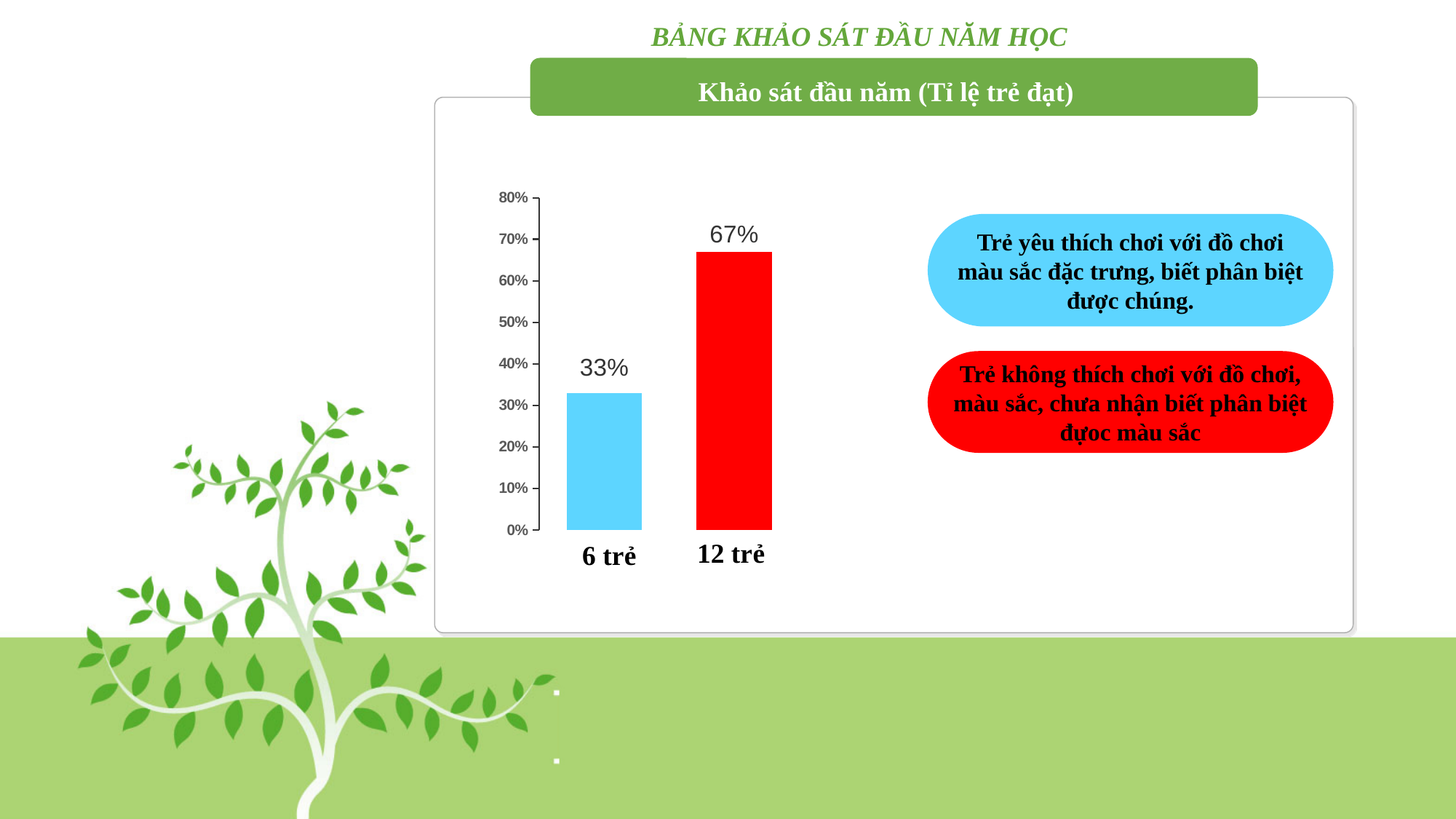
How many bars are plotted in the chart? 2 What is the difference between the "12 trẻ" value and the "6 trẻ" value? 34% What is the value shown for the "6 trẻ" bar? 33% Is the value for "12 trẻ" greater or less than 60%? greater What colour is the "12 trẻ" bar? Red Which bar has the highest value? 12 trẻ Which bar has the lowest value? 6 trẻ What is the value shown for the "12 trẻ" bar? 67% What is the title of the chart? Khảo sát đầu năm (Tỉ lệ trẻ đạt) Which is larger, the value for "6 trẻ" or the value for "12 trẻ"? 12 trẻ What kind of chart is shown on the slide? Bar chart Is the value for "6 trẻ" greater or less than 40%? less